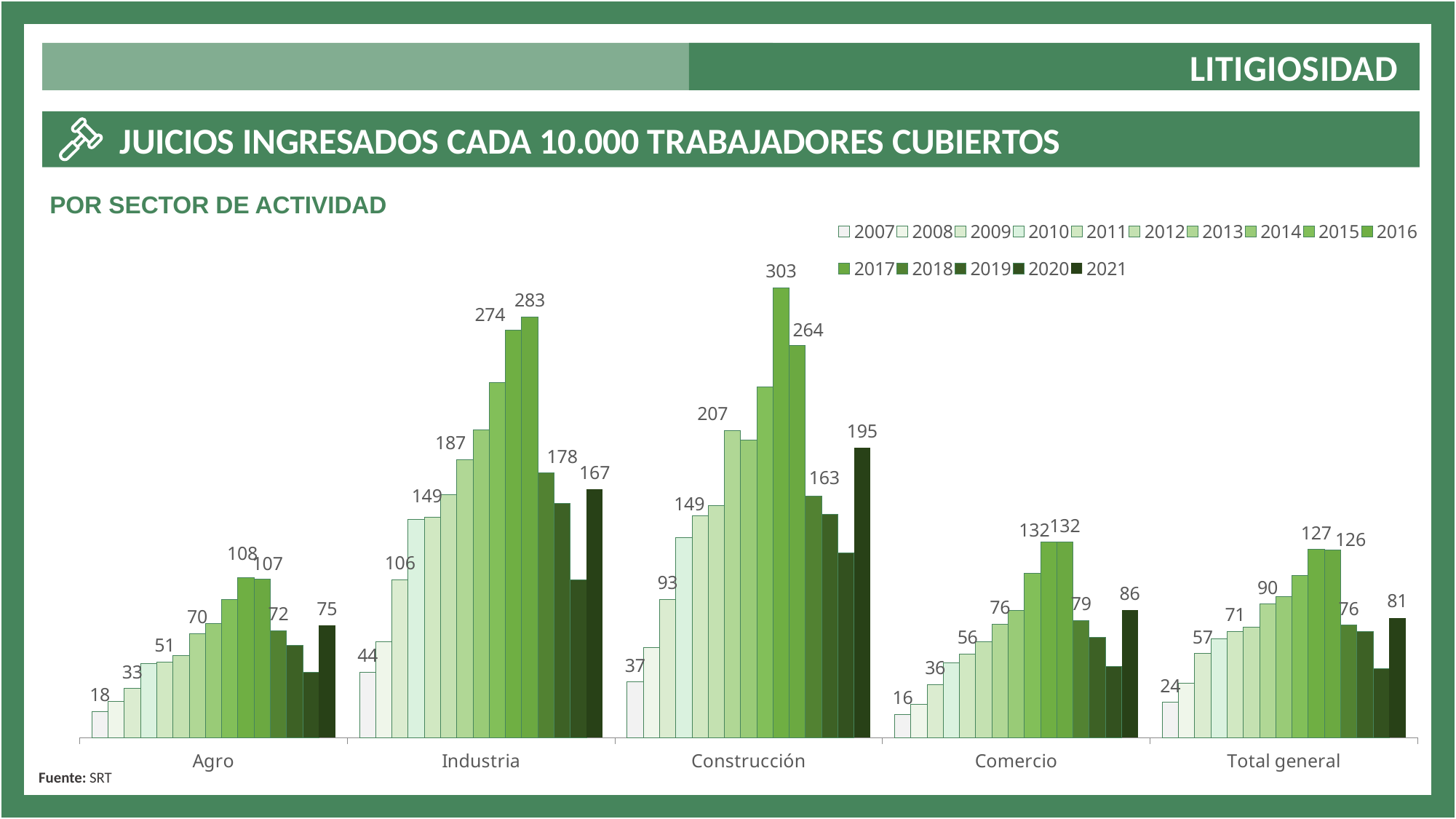
What is the title of the chart? JUICIOS INGRESADOS CADA 10.000 TRABAJADORES CUBIERTOS What is the value for Construcción in 2021? 195 What kind of chart is shown on the slide? bar chart Which sector reaches the highest value in the whole chart? Construcción In 2021, which is larger: the value for Comercio or for Total general? Comercio How many sectors (categories) are shown along the x axis? 5 What is the value for Total general in 2021? 81 What is the difference between the 2021 and 2007 values for Industria? 123 Which sector has the lowest value in 2007? Comercio What is the highest value shown for Construcción? 303 What is the value for Agro in 2007? 18 How many years (series) does the legend list? 15